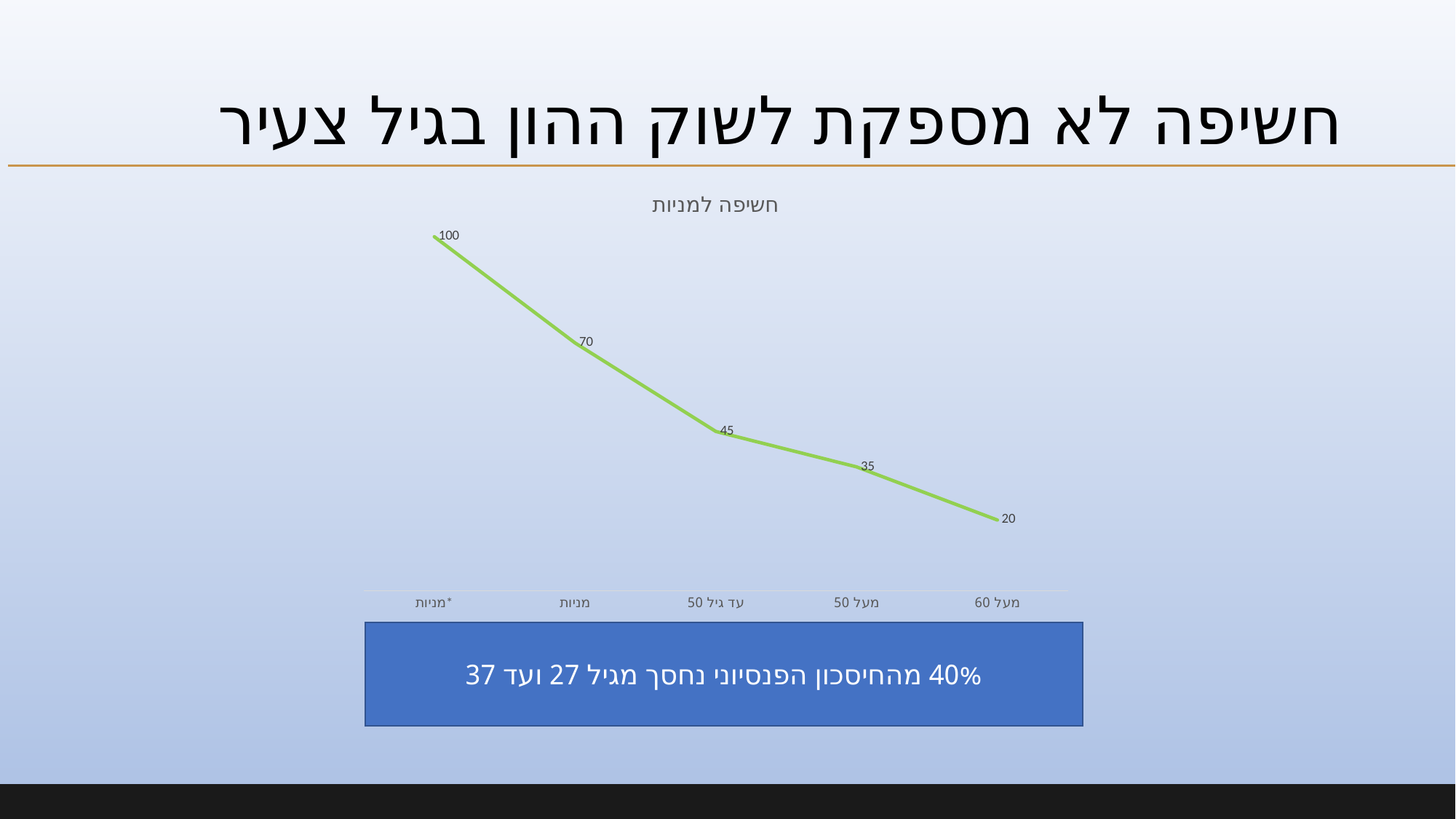
How many categories are plotted on the x axis of the chart? 5 What is the value for "עד גיל 50" in the chart? 45 What is the title of the chart? חשיפה למניות Which category has the lowest value in the chart? מעל 60 What is the value for "מעל 60" in the chart? 20 What is the value for "מניות*" in the chart? 100 What is the difference between the values for "מניות" and "עד גיל 50"? 25 Which category has the highest value in the chart? מניות* Which is larger, the value for "מעל 50" or the value for "מעל 60"? מעל 50 What is the value for "מעל 50" in the chart? 35 What kind of chart is shown on the slide? line chart Do the values rise or fall from left to right along the x axis? fall